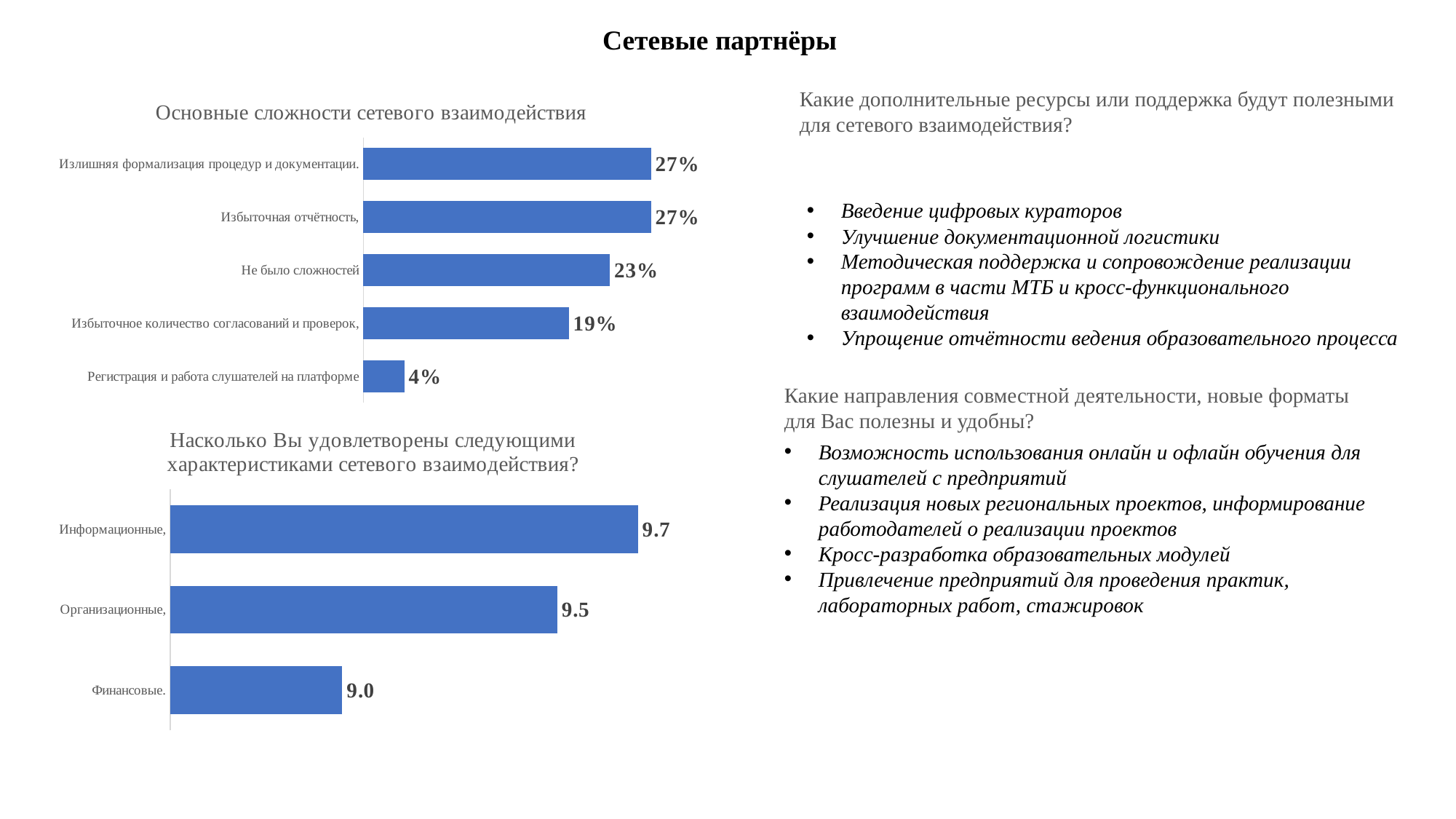
In the chart 'Основные сложности сетевого взаимодействия', what is the value for 'Регистрация и работа слушателей на платформе'? 4% In the chart 'Насколько Вы удовлетворены следующими характеристиками сетевого взаимодействия?', which category has the highest value? Информационные In the chart 'Насколько Вы удовлетворены следующими характеристиками сетевого взаимодействия?', what is the value for 'Организационные'? 9.5 In the chart 'Насколько Вы удовлетворены следующими характеристиками сетевого взаимодействия?', which category has the lowest value? Финансовые In the chart 'Основные сложности сетевого взаимодействия', which is larger: 'Избыточная отчётность' or 'Избыточное количество согласований и проверок'? Избыточная отчётность How many categories are shown in the chart 'Основные сложности сетевого взаимодействия'? 5 In the chart 'Основные сложности сетевого взаимодействия', what is the value for 'Не было сложностей'? 23% What kind of chart is 'Основные сложности сетевого взаимодействия'? Bar chart In the chart 'Насколько Вы удовлетворены следующими характеристиками сетевого взаимодействия?', what is the difference between 'Информационные' and 'Финансовые'? 0.7 In the chart 'Основные сложности сетевого взаимодействия', what is the difference between 'Не было сложностей' and 'Избыточное количество согласований и проверок'? 4% How many categories are shown in the chart 'Насколько Вы удовлетворены следующими характеристиками сетевого взаимодействия?'? 3 In the chart 'Основные сложности сетевого взаимодействия', which category has the lowest value? Регистрация и работа слушателей на платформе